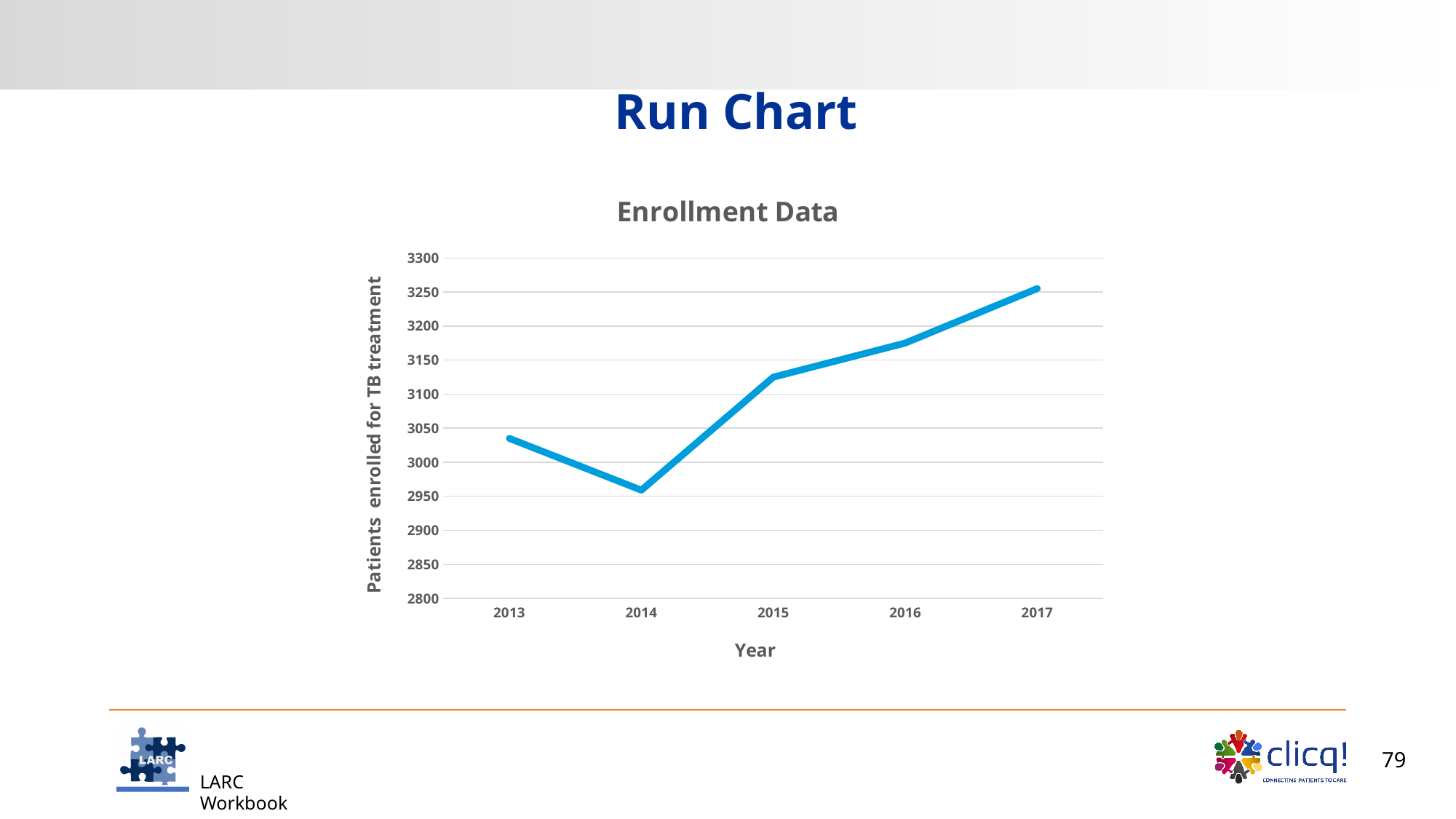
Which year has the highest number of patients enrolled? 2017 What is the label of the vertical axis? Patients enrolled for TB treatment Which year has more patients enrolled, 2014 or 2015? 2015 What kind of chart is shown on the slide? line chart What is the title of the chart? Enrollment Data Is the value for 2017 greater or less than 3200? greater Which year has the lowest number of patients enrolled? 2014 Is the value for 2013 greater or less than 3000? greater Do the values rise or fall from 2014 to 2017? rise How many years are plotted on the x axis? 5 Is the value for 2014 greater or less than 3000? less